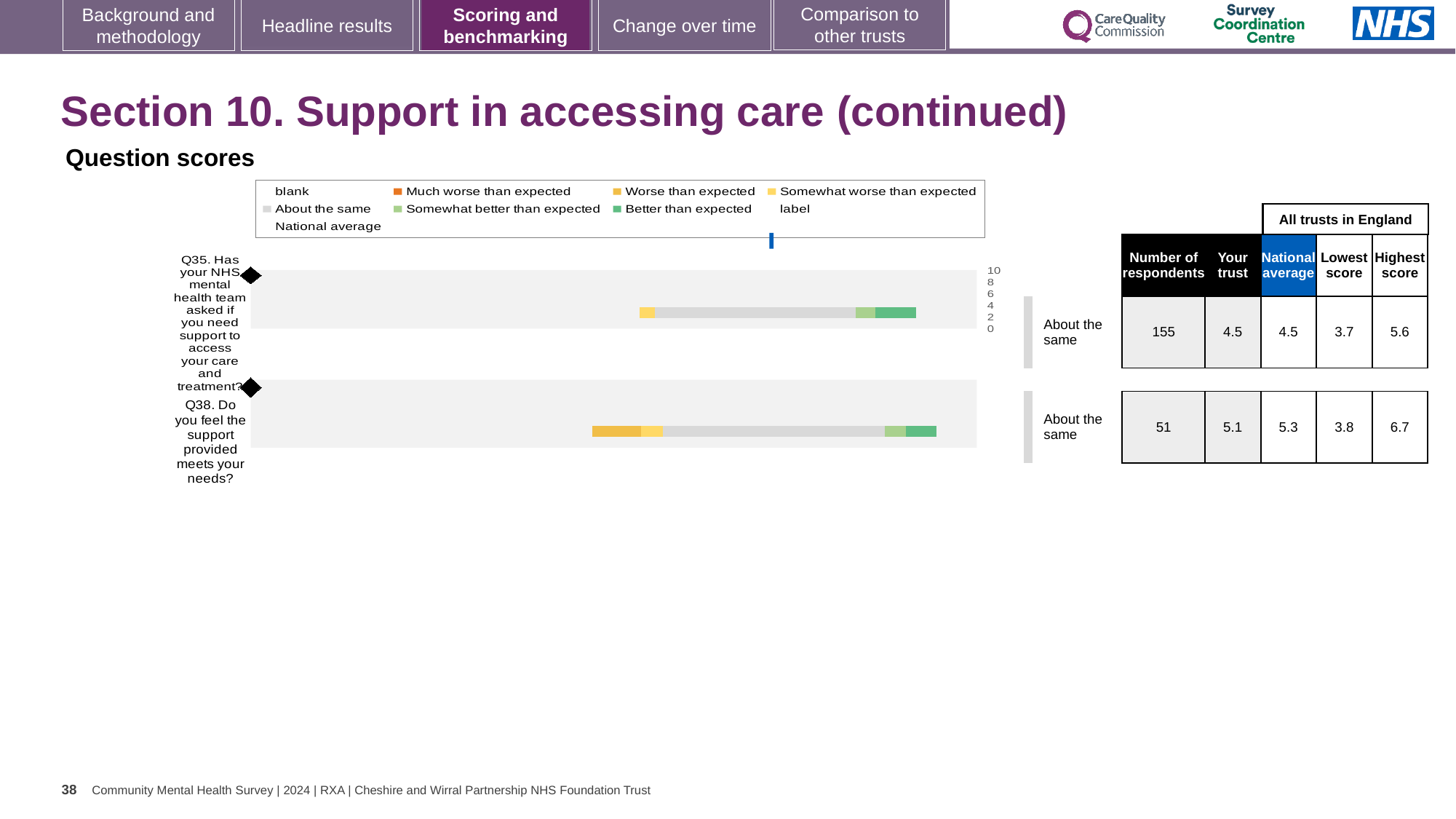
What is the national average score for Q35 in the question scores table? 4.5 How many respondents are listed for Q35 in the question scores table? 155 How many questions are plotted in the question scores chart? 2 What is the difference between the highest score and the lowest score for Q38? 2.9 In the question scores chart, what colour represents 'Better than expected' in the legend? green For Q38, which is larger: the 'Your trust' score or the national average? National average What is the highest score among all trusts in England for Q38? 6.7 What kind of chart is used to show the question scores on this slide? bar chart What is the 'Your trust' score for Q38 (Do you feel the support provided meets your needs?)? 5.1 What benchmark category is shown next to Q35 in the question scores chart? About the same Which question has the higher 'Your trust' score, Q35 or Q38? Q38 What is the difference between the highest score and the lowest score for Q35? 1.9